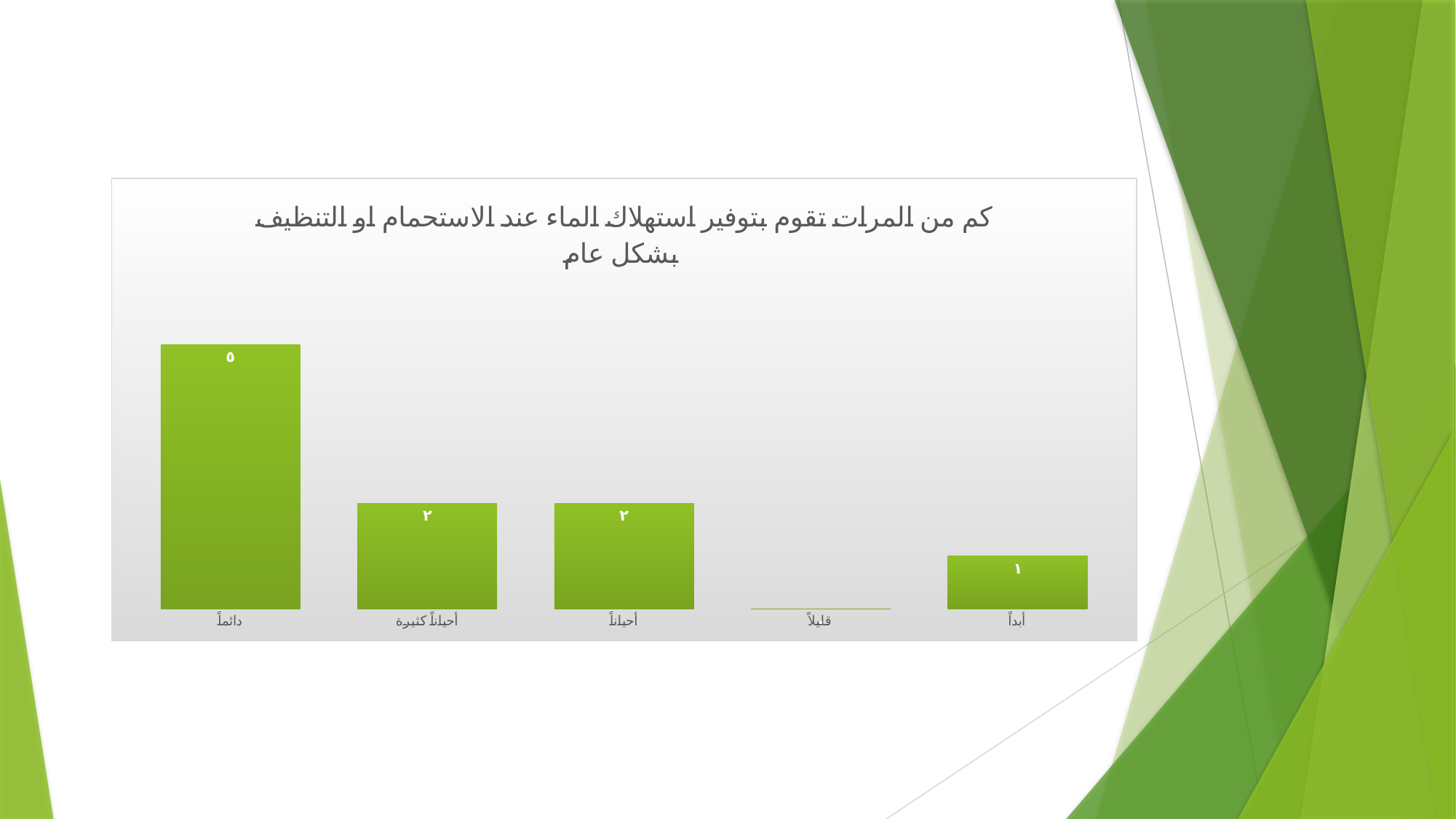
Which is larger, the value for أحياناً or the value for أبداً? أحياناً What is the difference between the values for دائماً and أبداً? ٤ What is the value for أحياناً كثيرة? ٢ Which category has the lowest value? قليلاً What is the value for دائماً? ٥ What colour are the bars in the chart? Green Which category has the highest value? دائماً What is the value for أبداً? ١ How many categories are shown on the x axis? 5 What kind of chart is shown on the slide? Bar chart What is the value for أحياناً? ٢ What is the difference between the values for دائماً and أحياناً كثيرة? ٣